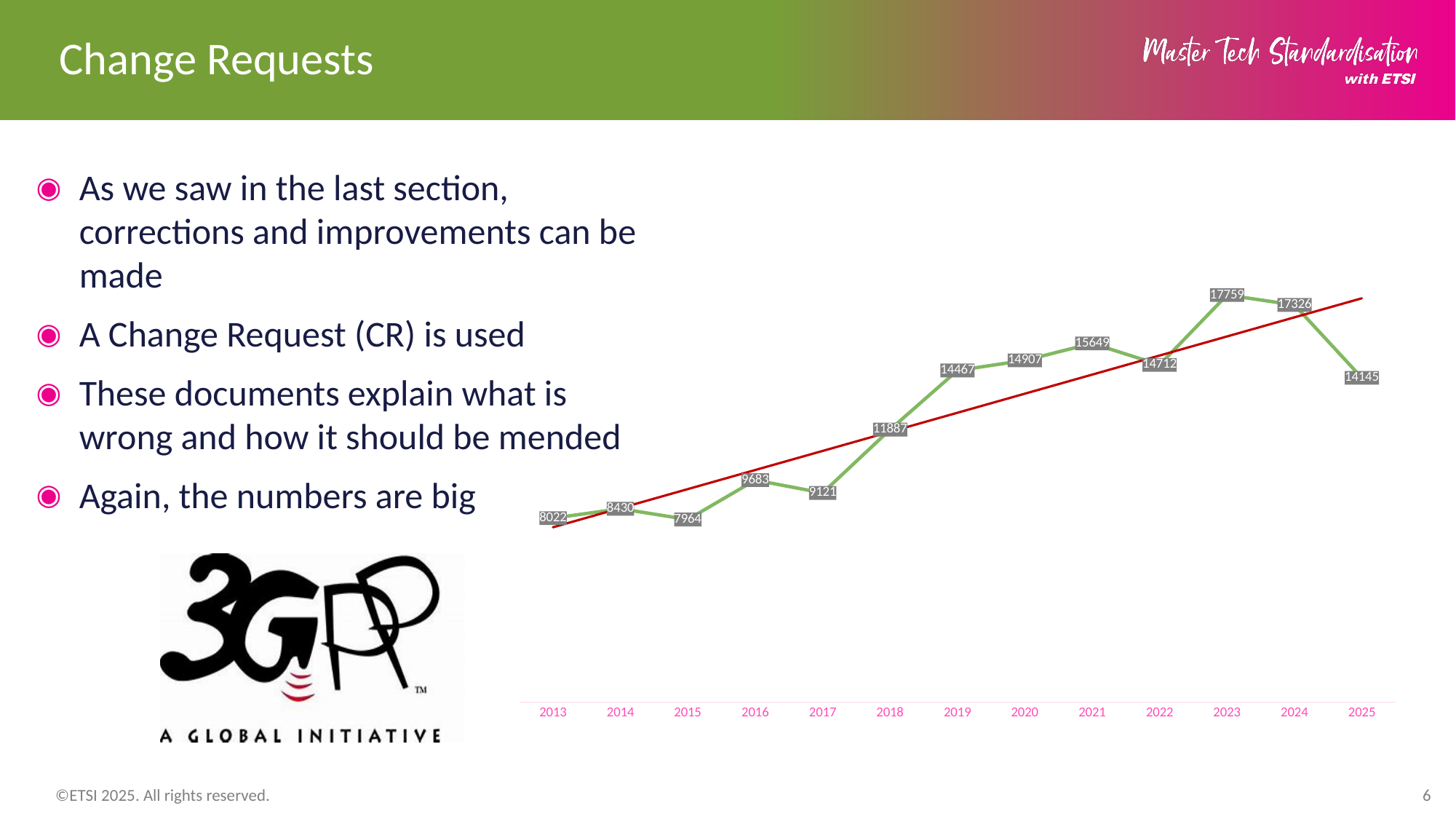
What type of chart is shown on the slide? Line chart What is the value plotted for 2013? 8022 Which year has the highest value on the chart? 2023 What is the difference between the values for 2024 and 2025? 3181 What is the difference between the values for 2023 and 2024? 433 Which is larger, the value for 2021 or the value for 2022? 2021 How many years are plotted on the x axis? 13 What is the value plotted for 2025? 14145 What is the value plotted for 2018? 11887 What colour is the straight trend line drawn across the chart? Red Do the values generally rise or fall from 2013 to 2023? Rise Which year has the lowest value on the chart? 2015